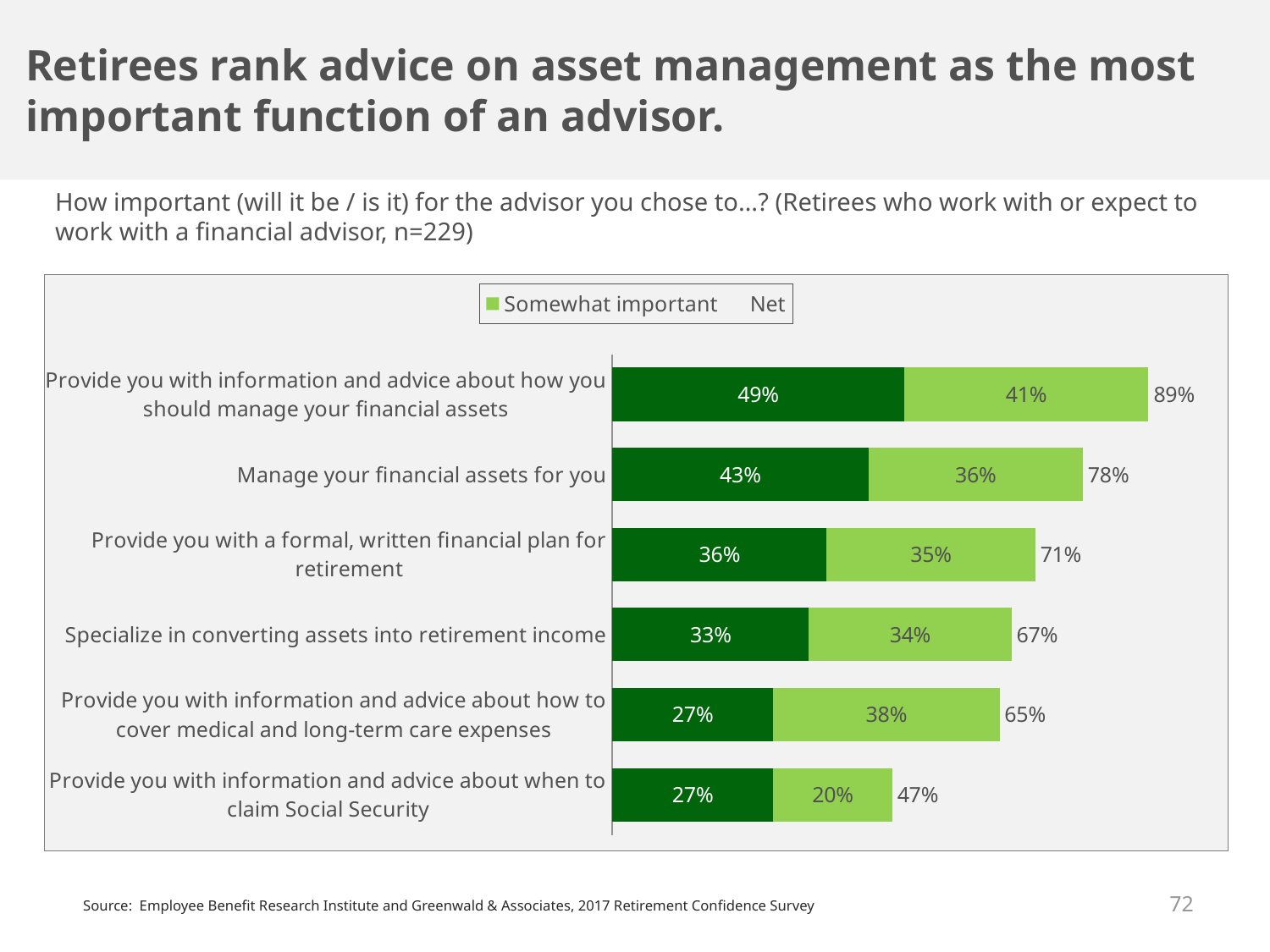
Which category has the lowest Net value? Provide you with information and advice about when to claim Social Security Which has a larger "Somewhat important" value: "Provide you with information and advice about how to cover medical and long-term care expenses" or "Specialize in converting assets into retirement income"? Provide you with information and advice about how to cover medical and long-term care expenses What kind of chart is shown on the slide? Stacked horizontal bar chart What is the difference between the Net values for "Manage your financial assets for you" and "Provide you with a formal, written financial plan for retirement"? 7% What is the sample size (n) stated in the chart's subtitle? 229 What is the "Somewhat important" value for "Manage your financial assets for you"? 36% Which category has the highest Net value? Provide you with information and advice about how you should manage your financial assets How many categories are shown in the chart? 6 What is the Net value for "Specialize in converting assets into retirement income"? 67% What is the Net value for "Provide you with information and advice about how you should manage your financial assets"? 89% What is the difference between the Net values for the highest and lowest categories? 42% What is the "Somewhat important" value for "Provide you with information and advice about when to claim Social Security"? 20%